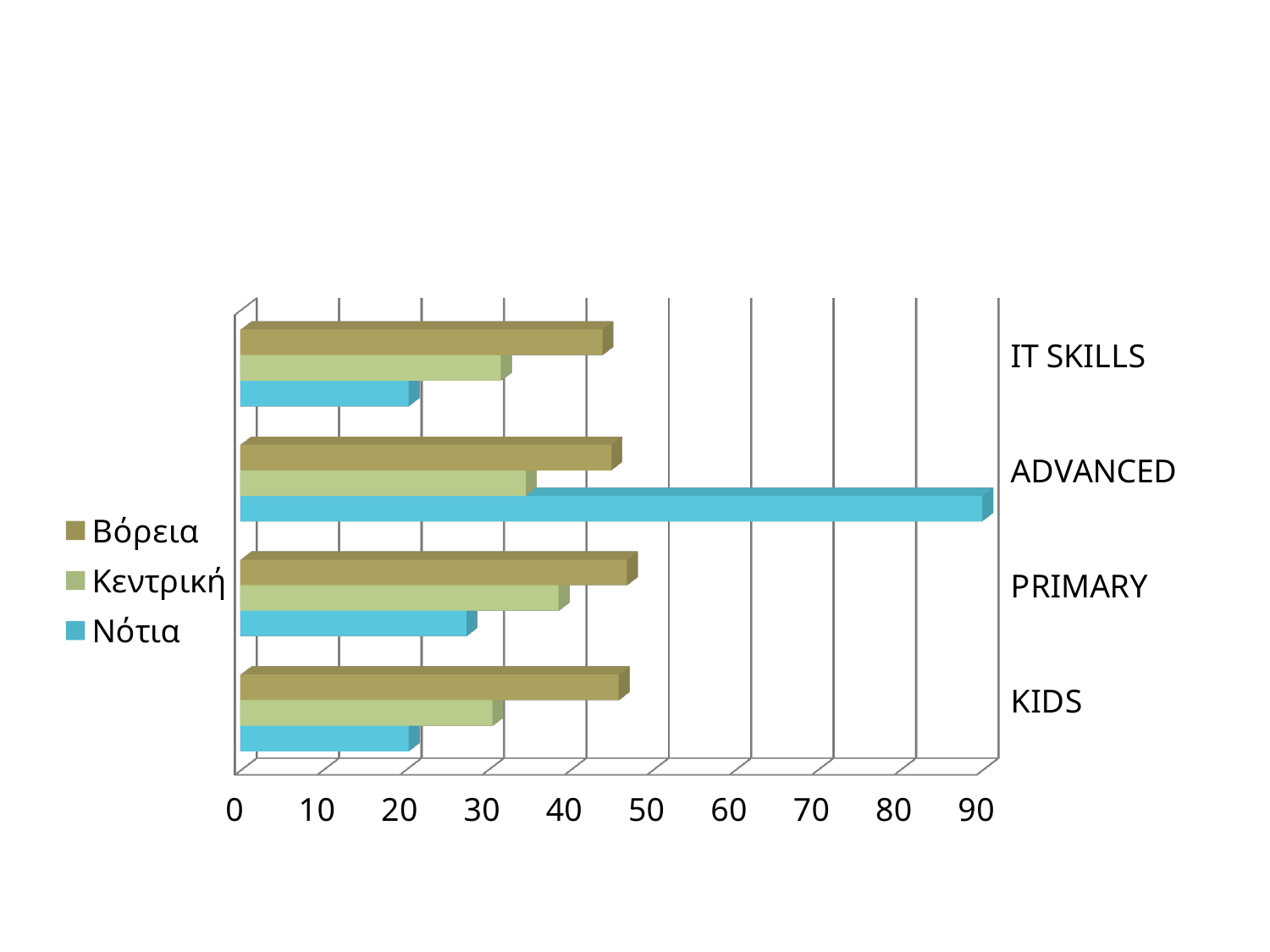
How many series does the legend list? 3 Is the Νότια value for ADVANCED greater or less than 80? greater Which series has the lowest value for KIDS? Νότια Which series is shown in blue in the legend? Νότια Which category has the highest value for the Νότια series? ADVANCED What kind of chart is shown on the slide? bar chart Is the Βόρεια value for PRIMARY greater or less than 40? greater Is the Κεντρική value for KIDS greater or less than 40? less Which is larger: the Νότια value for ADVANCED or the Νότια value for KIDS? ADVANCED Which series has the highest value for IT SKILLS? Βόρεια How many categories are shown on the chart? 4